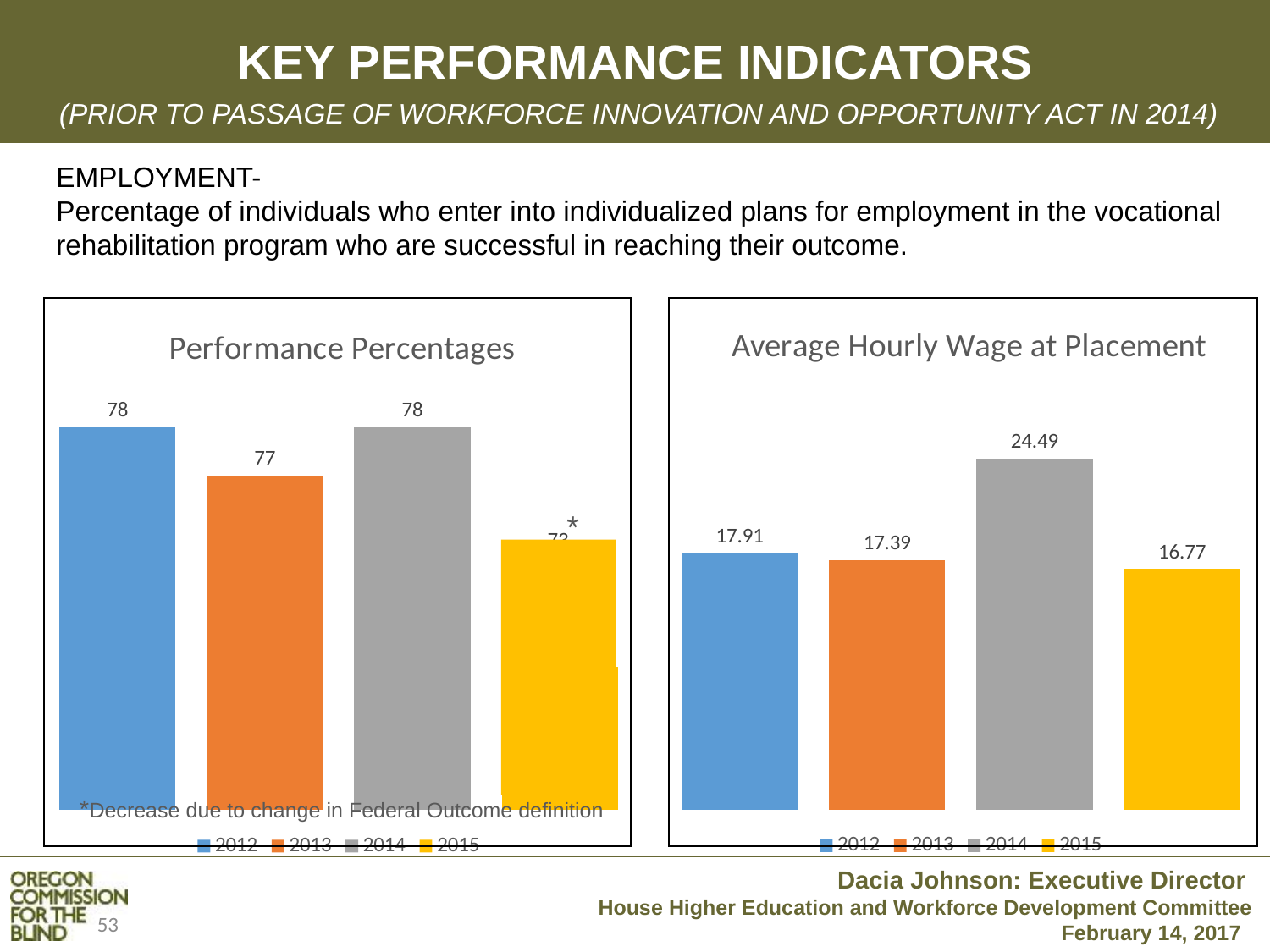
In the Performance Percentages chart, what is the value for 2013? 77 What kind of chart is the Performance Percentages chart? Bar chart In the Average Hourly Wage at Placement chart, what is the difference between the 2014 and 2015 values? 7.72 In the Average Hourly Wage at Placement chart, which year has the highest value? 2014 In the Average Hourly Wage at Placement chart, what is the value for 2014? 24.49 In the Average Hourly Wage at Placement chart, which year has the lowest value? 2015 In the Performance Percentages chart, which year has the lowest value? 2015 In the Average Hourly Wage at Placement chart, which is larger, the value for 2012 or the value for 2013? 2012 In the Average Hourly Wage at Placement chart, what is the value for 2012? 17.91 In the Performance Percentages chart, what is the difference between the 2012 and 2013 values? 1 How many series does the legend of the Average Hourly Wage at Placement chart list? 4 In the Performance Percentages chart, what is the value for 2012? 78